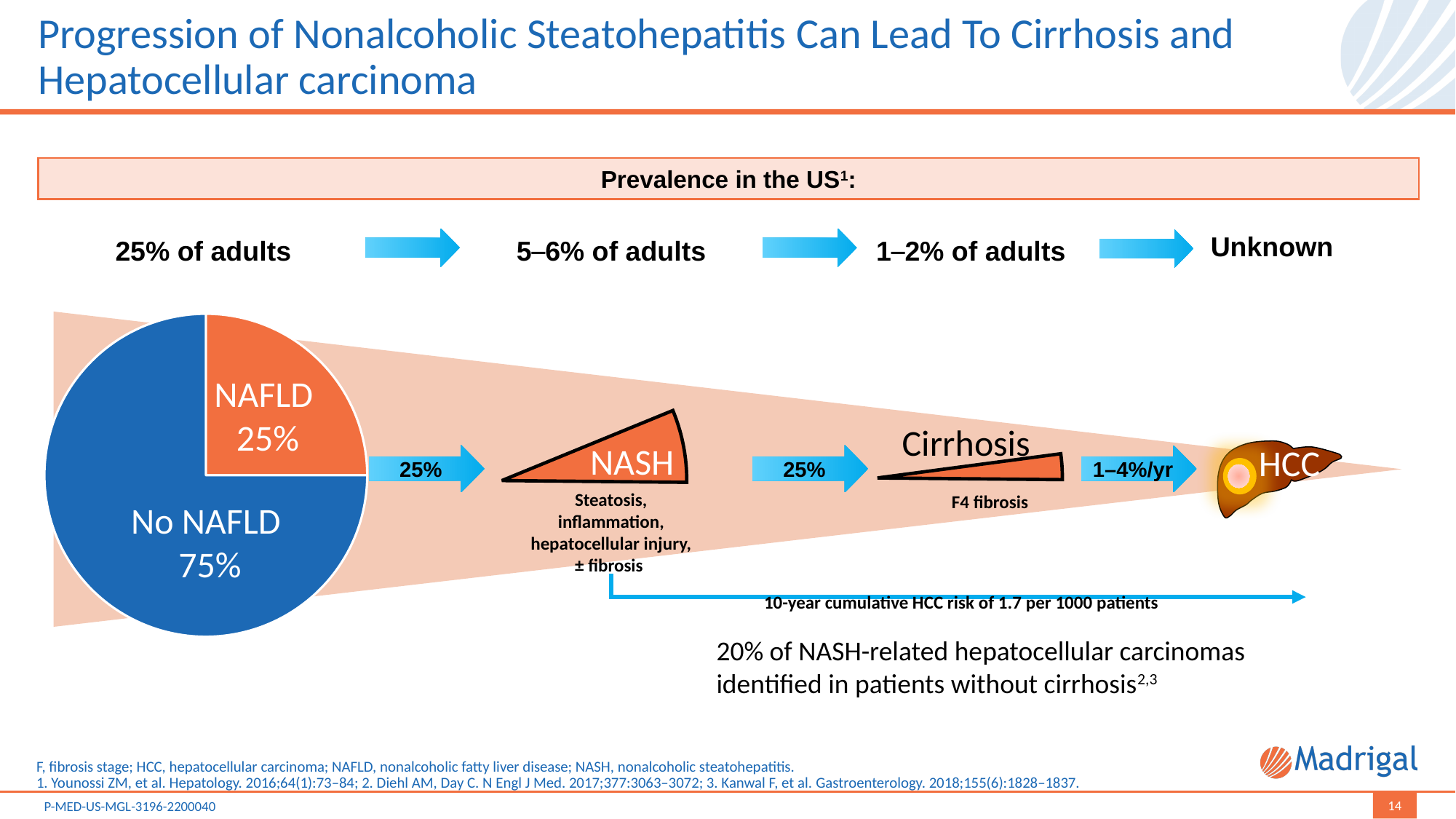
In the pie chart, what share is labelled for No NAFLD? 75% What is the total of the two slices shown in the pie chart? 100% Which slice of the pie chart is the largest? No NAFLD In the pie chart, what share is labelled for NAFLD? 25% What kind of chart is shown on the slide? pie chart Which slice of the pie chart is the smallest? NAFLD What colour is the No NAFLD slice of the pie chart? blue How many slices does the pie chart have? 2 What colour is the NAFLD slice of the pie chart? orange What is the difference in percentage points between the No NAFLD slice and the NAFLD slice? 50 Which is larger in the pie chart, the NAFLD slice or the No NAFLD slice? No NAFLD